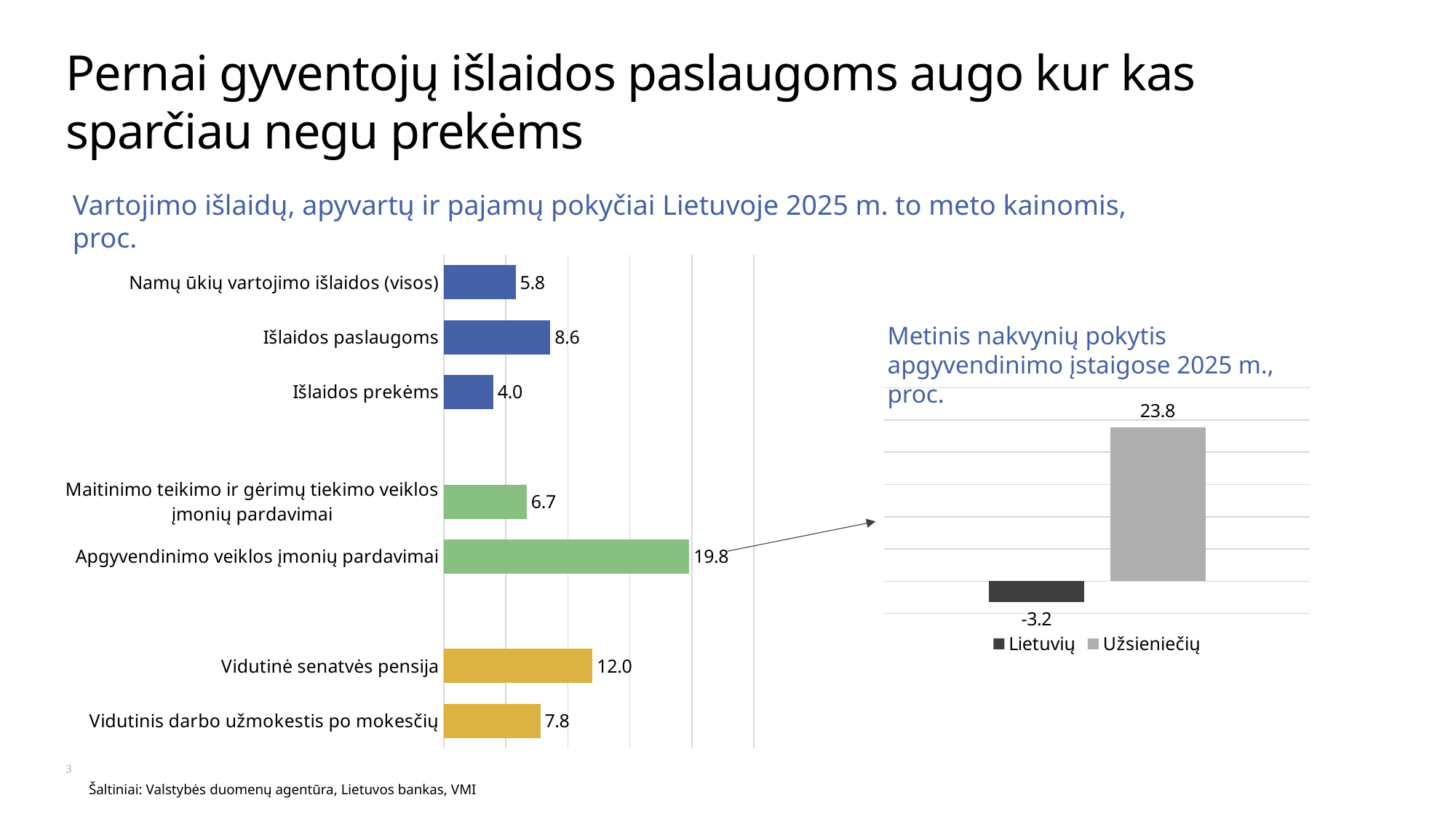
In the left chart, what is the difference between 'Išlaidos paslaugoms' and 'Išlaidos prekėms'? 4.6 In the left chart, what is the value for 'Vidutinė senatvės pensija'? 12.0 In the right chart 'Metinis nakvynių pokytis apgyvendinimo įstaigose 2025 m., proc.', what is the value for 'Užsieniečių'? 23.8 How many categories are plotted in the left chart? 7 In the left chart, which category has the highest value? Apgyvendinimo veiklos įmonių pardavimai In the right chart, what is the difference between 'Užsieniečių' and 'Lietuvių'? 27.0 In the left chart, which category has the lowest value? Išlaidos prekėms In the left chart 'Vartojimo išlaidų, apyvartų ir pajamų pokyčiai Lietuvoje 2025 m. to meto kainomis, proc.', what is the value for 'Išlaidos paslaugoms'? 8.6 What kind of chart is the left chart? Bar chart In the left chart, which is larger: 'Vidutinė senatvės pensija' or 'Vidutinis darbo užmokestis po mokesčių'? Vidutinė senatvės pensija In the right chart, what is the value for 'Lietuvių'? -3.2 How many series does the legend of the right chart list? 2